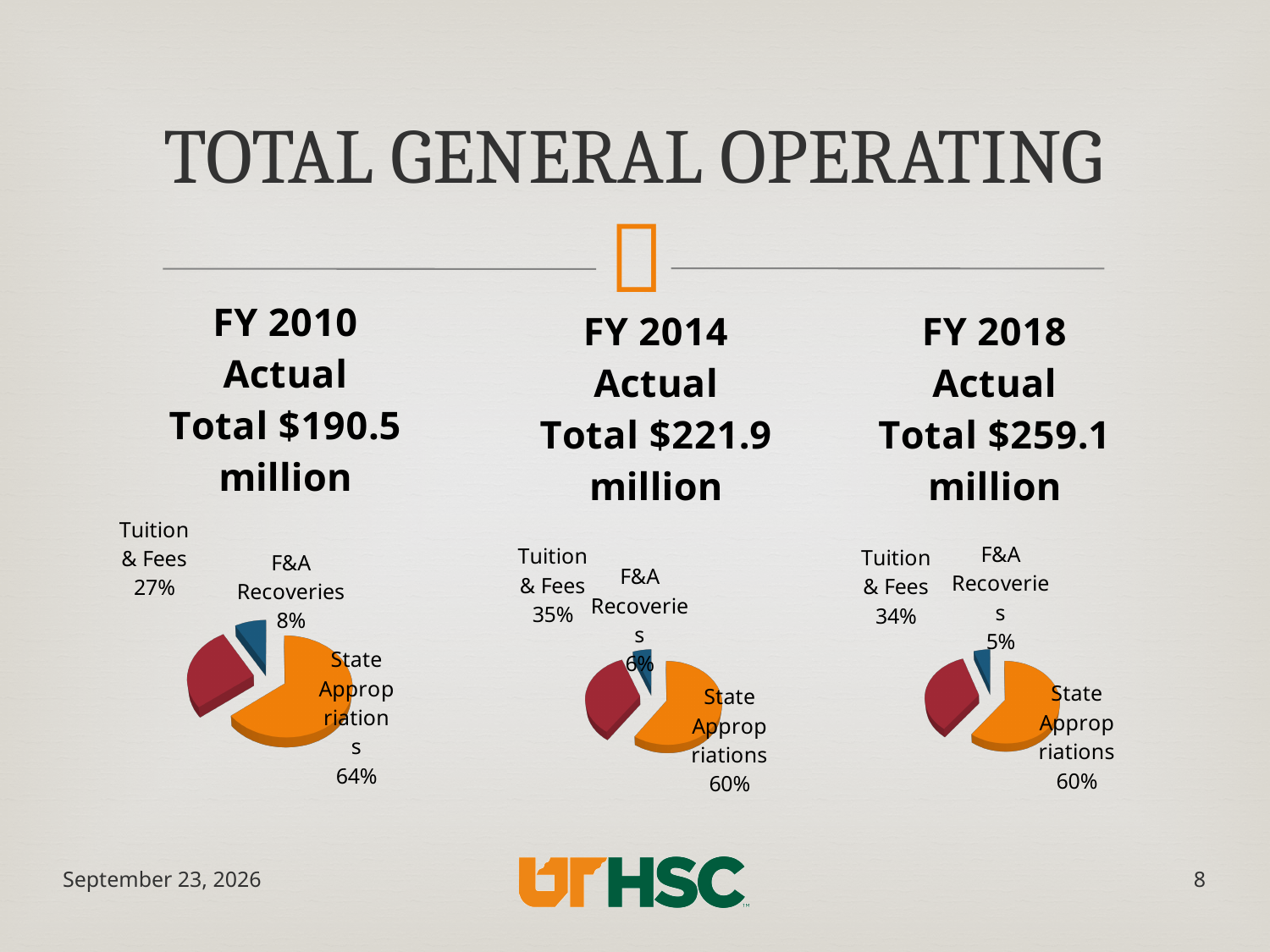
In the FY 2010 pie chart, what share is F&A Recoveries? 8% In the FY 2014 pie chart, what share is State Appropriations? 60% In the FY 2010 pie chart, which category has the smallest share? F&A Recoveries In the FY 2018 pie chart, what share is Tuition & Fees? 34% In the FY 2010 pie chart, what share is Tuition & Fees? 27% In the FY 2014 pie chart, which category has the largest share? State Appropriations In the FY 2014 pie chart, what is the difference between the Tuition & Fees share and the F&A Recoveries share? 29% In the FY 2018 pie chart, what share is F&A Recoveries? 5% Is the Tuition & Fees share larger in the FY 2010 chart or the FY 2014 chart? FY 2014 How many slices does the FY 2018 pie chart have? 3 What is the total shown in the heading above the FY 2014 pie chart? $221.9 million What type of chart is used for FY 2010, FY 2014 and FY 2018? Pie chart